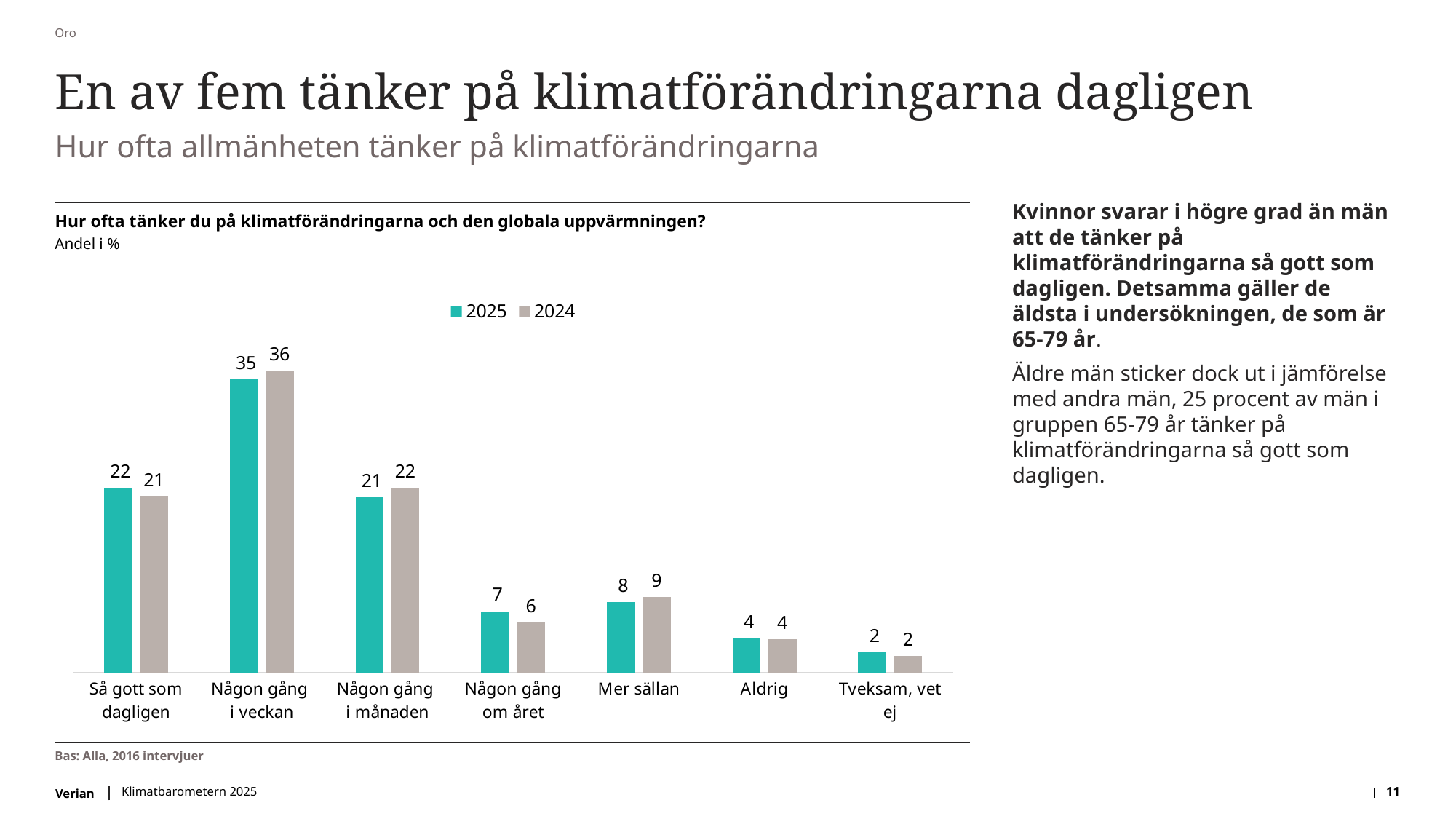
What is the 2025 value for "Så gott som dagligen"? 22 What is the difference between the 2025 and 2024 values for "Någon gång i månaden"? 1 How many series does the legend list? 2 Which series is shown in teal in the legend? 2025 How many categories are shown on the x axis? 7 Which category has the highest 2025 value? Någon gång i veckan What is the 2025 value for "Mer sällan"? 8 What is the 2024 value for "Någon gång i veckan"? 36 What kind of chart is shown on the slide? Bar chart Which category has the lowest 2024 value? Tveksam, vet ej Which is larger for "Någon gång om året": the 2025 value or the 2024 value? 2025 What is the 2025 value for "Aldrig"? 4